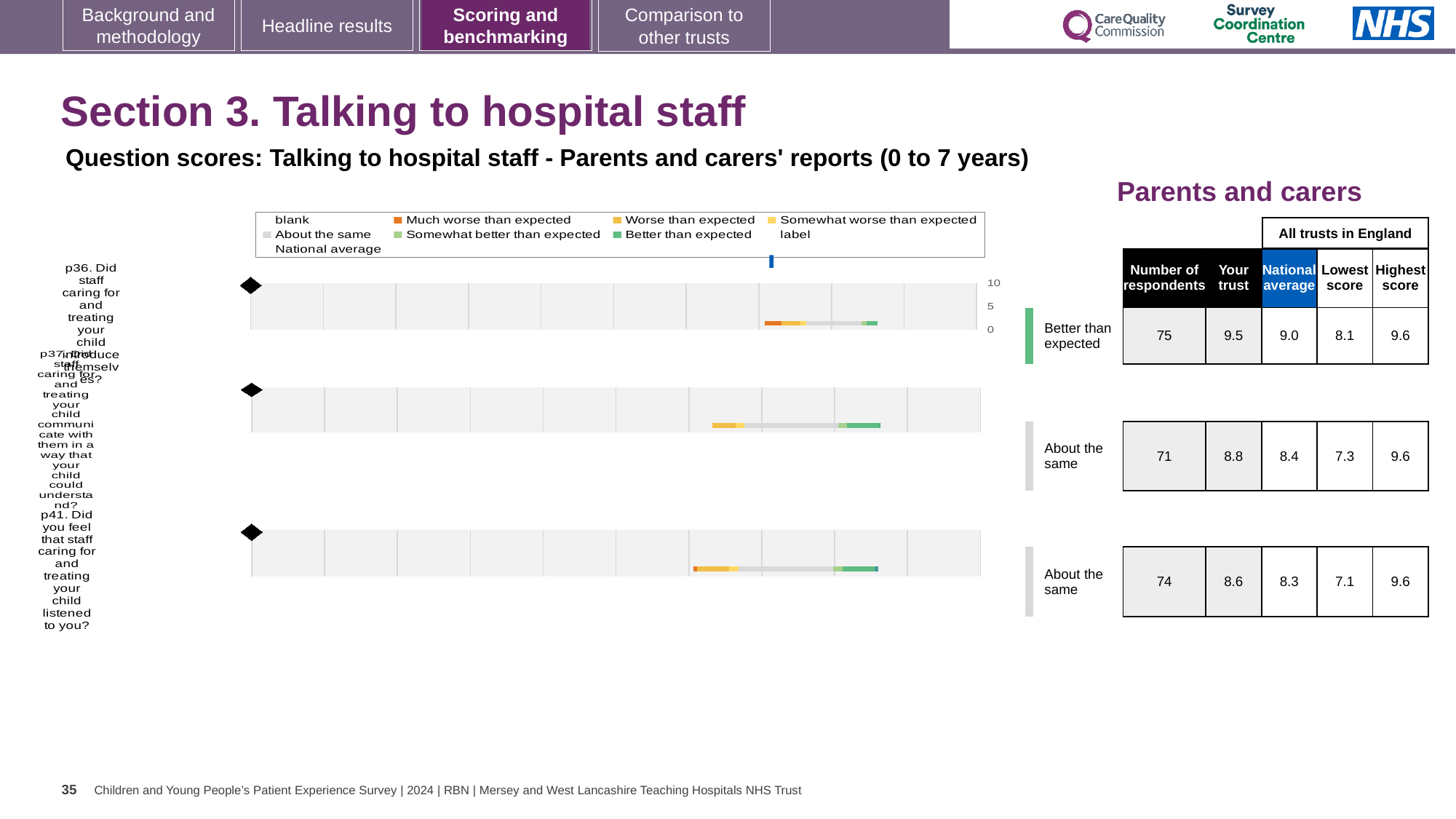
What is the highest value shown on the chart's numeric axis? 10 Which colour in the legend represents 'Better than expected'? green What is the difference between the 'Your trust' score and the national average for p36? 0.5 How many question charts (p36, p37, p41) are shown on the slide? 3 Is the 'Your trust' score for p37 larger or smaller than the national average for p37? larger In the table, how many respondents answered p41 (Did you feel that staff listened to you)? 74 In the table, what is the national average for p37 (Did staff communicate with your child in a way they could understand)? 8.4 What benchmark category is shown next to the p36 chart? Better than expected What kind of chart is used to show the question scores on this slide? bar chart Which of the three questions has the lowest 'Your trust' score in the table? p41 Which of the three questions has the highest 'Your trust' score in the table? p36 In the table, what is the 'Your trust' score for p36 (Did staff caring for and treating your child introduce themselves)? 9.5